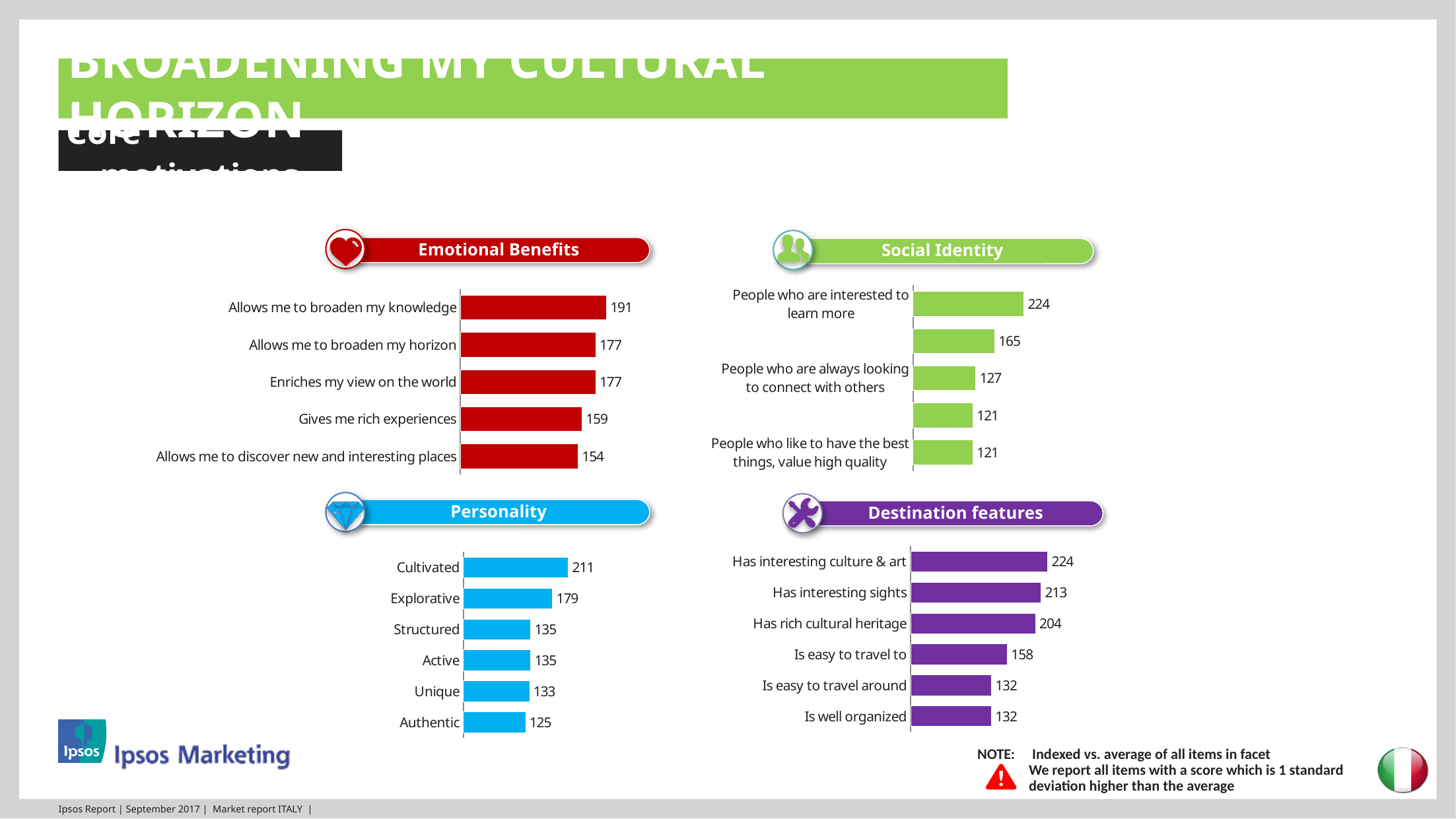
How many categories are shown in the Emotional Benefits chart? 5 In the Personality chart, what is the value for "Authentic"? 125 What type of chart is the Destination features chart? Bar chart In the Emotional Benefits chart, what is the difference between "Allows me to broaden my knowledge" and "Gives me rich experiences"? 32 How many categories are shown in the Destination features chart? 6 In the Emotional Benefits chart, which category has the lowest value? Allows me to discover new and interesting places In the Emotional Benefits chart, what is the value for "Allows me to broaden my knowledge"? 191 In the Personality chart, which is larger, "Explorative" or "Unique"? Explorative In the Personality chart, which category has the highest value? Cultivated In the Social Identity chart, what is the value for "People who are interested to learn more"? 224 In the Destination features chart, what is the difference between "Has interesting culture & art" and "Is well organized"? 92 In the Social Identity chart, what is the value for "People who are always looking to connect with others"? 127